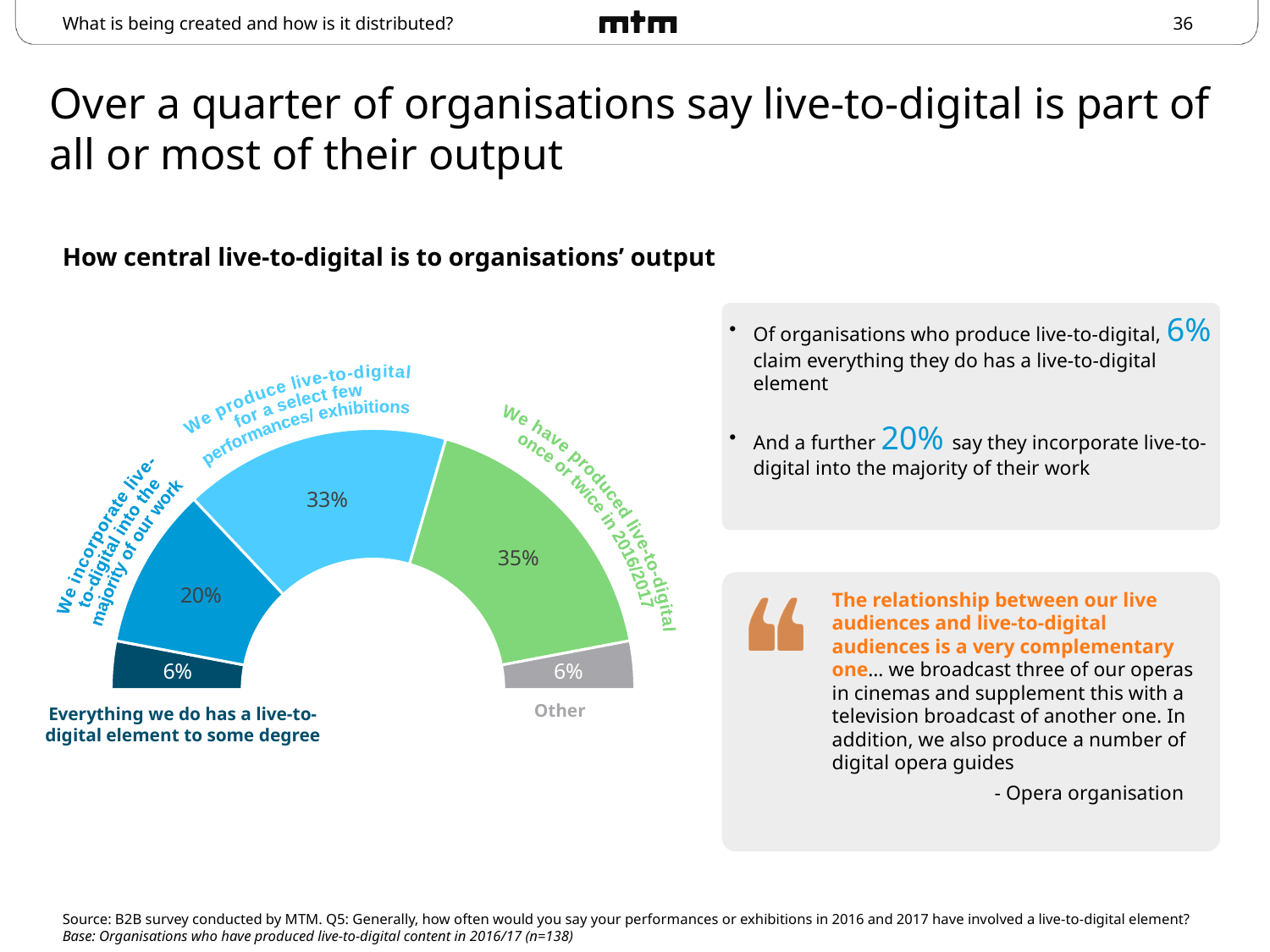
What percentage of organisations say they have produced live-to-digital once or twice in 2016/2017? 35% What percentage of organisations say everything they do has a live-to-digital element to some degree? 6% What percentage of organisations fall into the 'Other' category? 6% Which category has the largest share in the chart? We have produced live-to-digital once or twice in 2016/2017 How many segments does the chart have? 5 What kind of chart is shown on the slide? Semi-circular donut (pie) chart What percentage of organisations say they incorporate live-to-digital into the majority of their work? 20% What percentage of organisations say they produce live-to-digital for a select few performances/exhibitions? 33% What is the title of the chart? How central live-to-digital is to organisations' output What is the combined percentage of organisations that say everything they do has a live-to-digital element and those that incorporate it into the majority of their work? 26% What is the difference in percentage points between the 'select few performances/exhibitions' segment and the 'majority of our work' segment? 13 Which is larger: the share for 'We produce live-to-digital for a select few performances/exhibitions' or the share for 'We incorporate live-to-digital into the majority of our work'? We produce live-to-digital for a select few performances/exhibitions